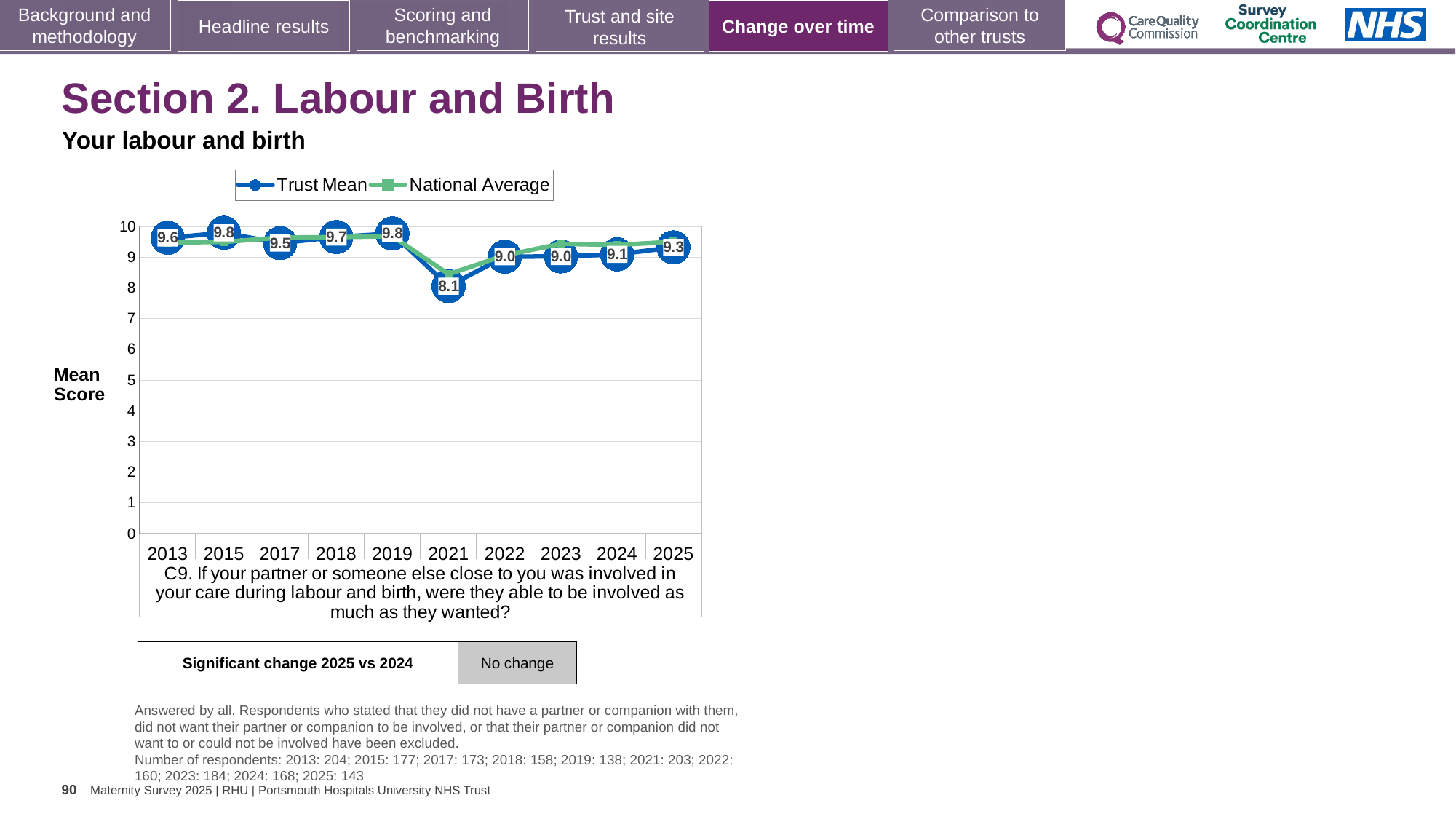
Does the Trust Mean rise or fall from 2021 to 2025? rise What kind of chart is shown on the slide? line chart What is the Trust Mean value for 2021? 8.1 What is the Trust Mean value for 2013? 9.6 What is the Trust Mean value for 2025? 9.3 Which year has the larger Trust Mean, 2018 or 2022? 2018 How many series does the legend list? 2 What is the highest Trust Mean value shown on the chart? 9.8 In which year is the Trust Mean lowest? 2021 Is the Trust Mean value for 2021 greater or less than 9? less What is the difference between the Trust Mean in 2019 and in 2021? 1.7 How many years are plotted on the x axis? 10